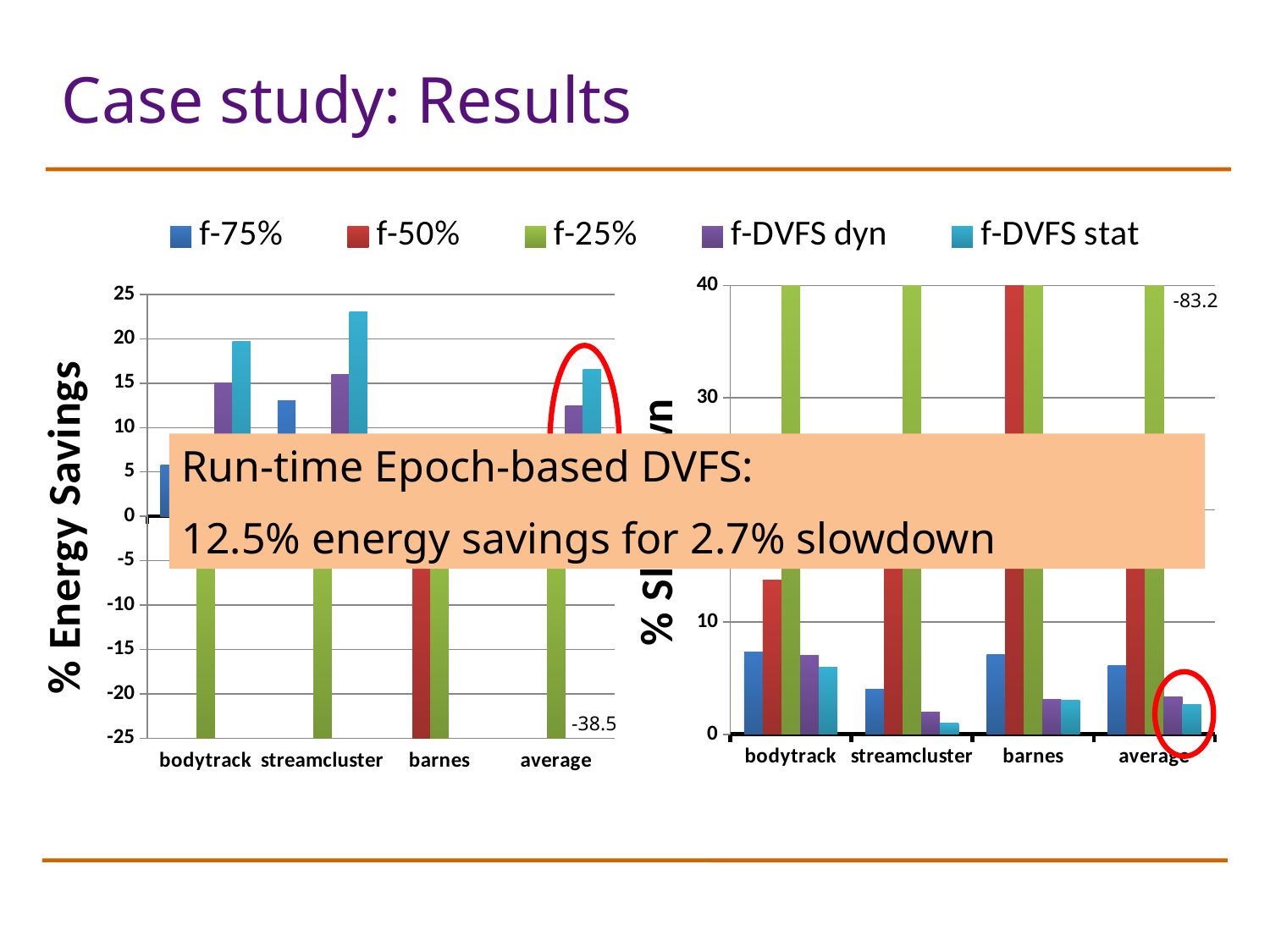
In the right chart (% Slowdown), what value is printed next to the clipped f-25% bar for average? -83.2 What kind of chart is the left chart (% Energy Savings)? bar chart In the right chart (% Slowdown), which category has the lowest f-75% value? streamcluster In the left chart (% Energy Savings), which is larger for bodytrack: f-DVFS dyn or f-DVFS stat? f-DVFS stat How many categories are shown on the x axis of the right chart? 4 In the right chart (% Slowdown), which is larger for streamcluster: f-DVFS dyn or f-DVFS stat? f-DVFS dyn In the left chart (% Energy Savings), is the value for f-DVFS stat for streamcluster greater or less than 20? greater In the left chart (% Energy Savings), what value is printed next to the clipped f-25% bar for average? -38.5 In the right chart (% Slowdown), is the value for f-75% for bodytrack greater or less than 10? less Which category is circled in red in both charts? average How many series does the legend list? 5 In the left chart (% Energy Savings), is the value for f-DVFS stat for bodytrack greater or less than 15? greater